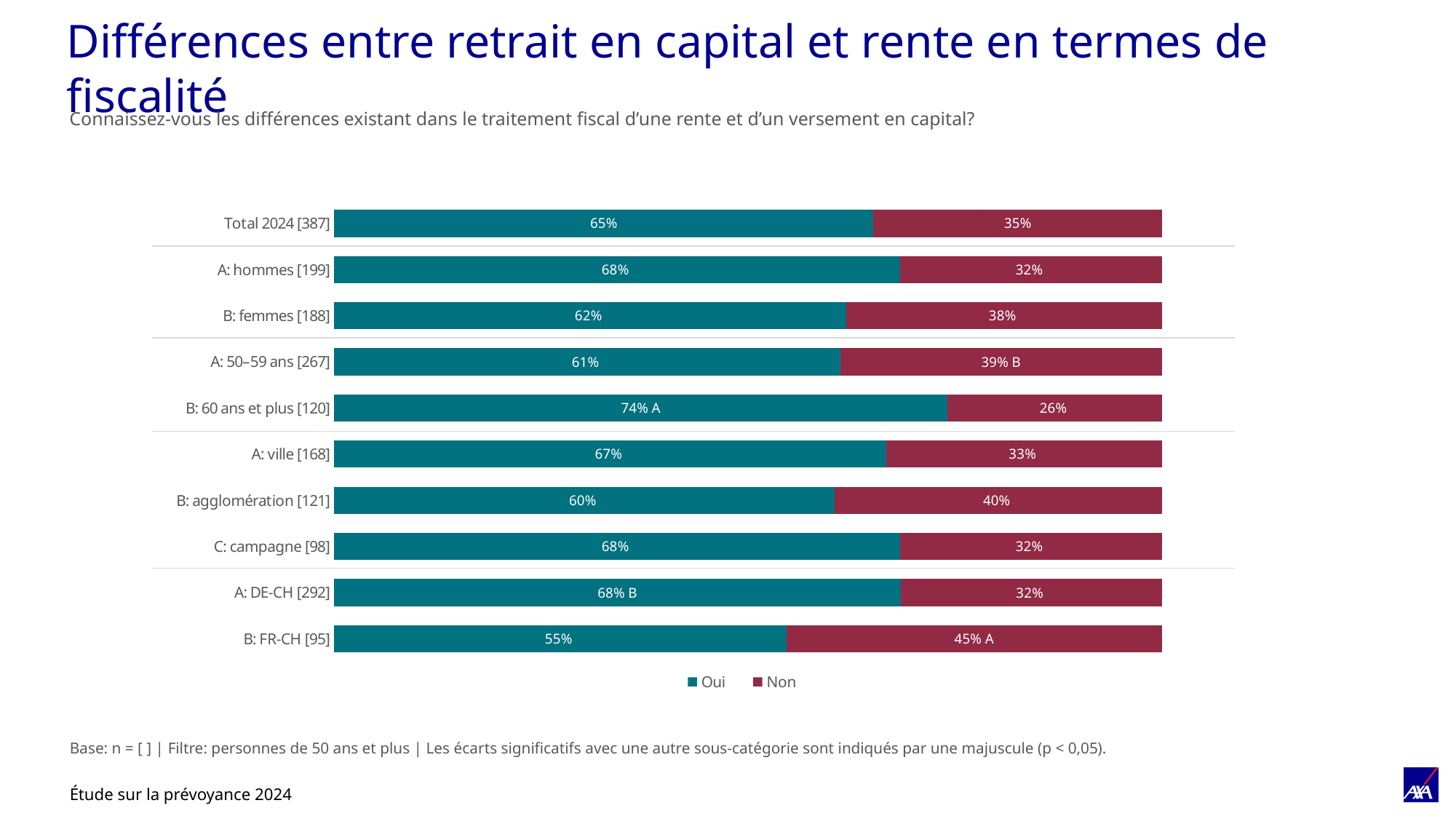
What is the 'Oui' value for B: 60 ans et plus [120]? 74% How many categories are shown on the chart? 10 What is the difference between the 'Oui' values for A: hommes [199] and B: femmes [188]? 6 percentage points Which category has the highest 'Oui' value? B: 60 ans et plus [120] What is the 'Non' value for B: FR-CH [95]? 45% Which has a larger 'Non' value, A: ville [168] or B: agglomération [121]? B: agglomération [121] What are the two legend entries of the chart? Oui and Non What is the total of the stacked bar for A: DE-CH [292]? 100% How many series does the legend list? 2 What kind of chart is shown on the slide? Stacked bar chart Which category has the lowest 'Oui' value? B: FR-CH [95] What is the 'Oui' value for Total 2024 [387]? 65%